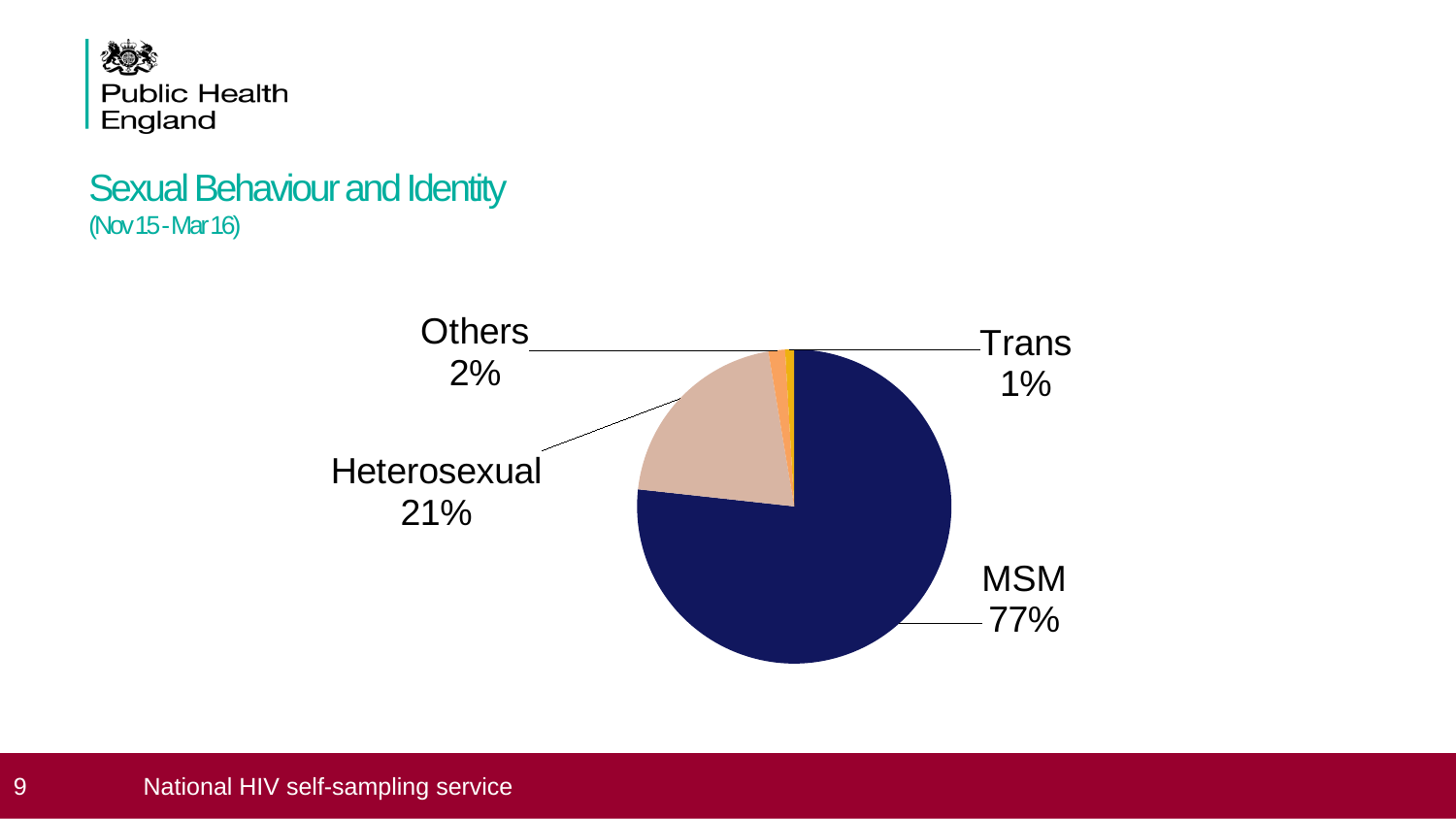
What is the title of the chart on the slide? Sexual Behaviour and Identity What is the difference in percentage points between MSM and Heterosexual? 56 What share of the pie does Others account for? 2% Which category has the smallest slice of the pie? Trans What share of the pie does Heterosexual account for? 21% Which is larger, the share for Heterosexual or the share for Others? Heterosexual What kind of chart is shown on the slide? Pie chart How many categories are shown in the pie chart? 4 Which category has the largest slice of the pie? MSM What share of the pie does MSM account for? 77% What time period is shown under the chart title? Nov 15 - Mar 16